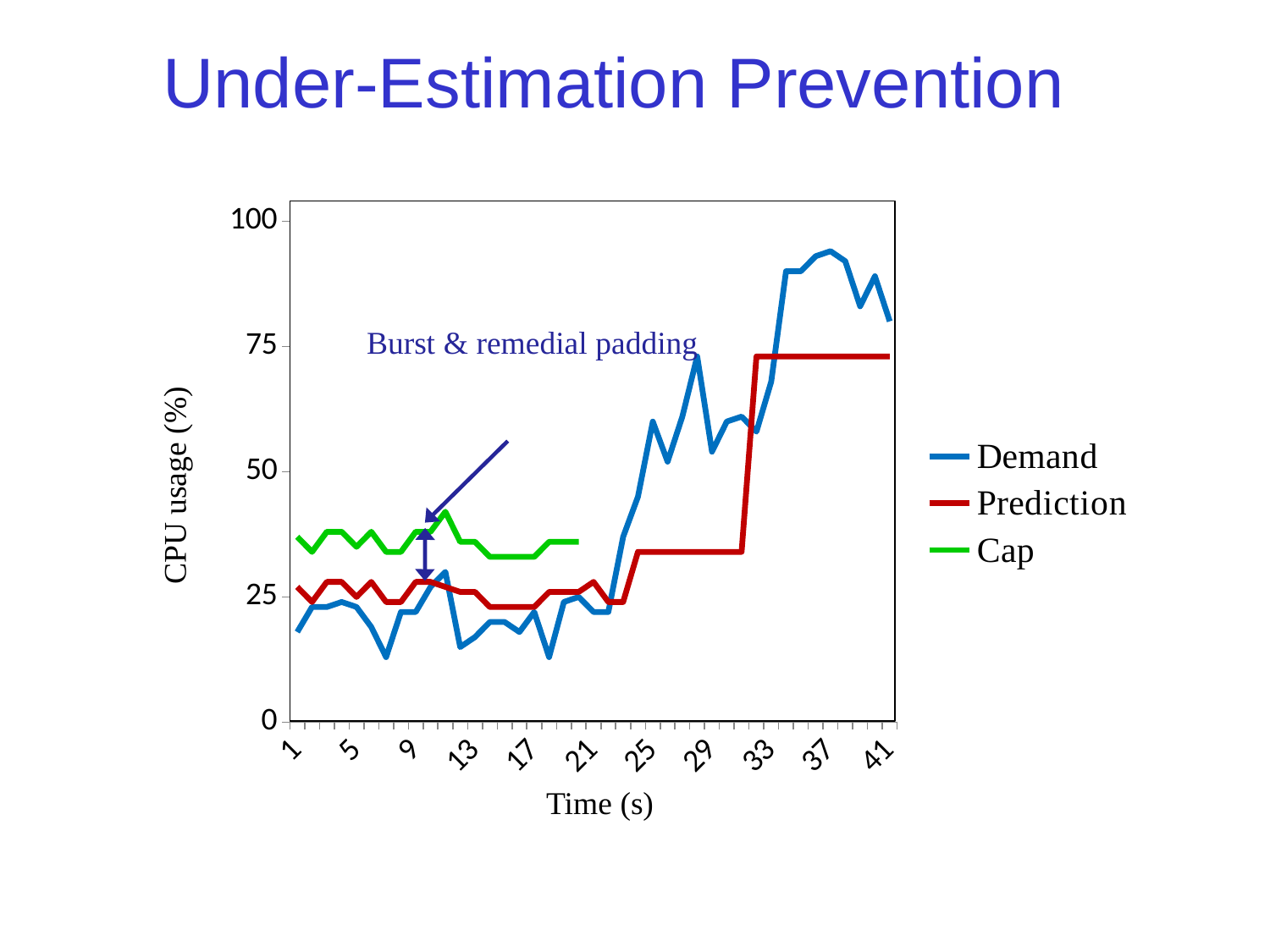
At time 37, which is larger, Demand or Prediction? Demand Is the Demand value at time 29 greater or less than 50? greater Which series reaches the highest value on the chart? Demand Is the Demand value at time 7 greater or less than 25? less What are the three series named in the legend? Demand, Prediction, Cap At time 9, which is larger, Cap or Demand? Cap Is the Prediction value at time 37 greater or less than 50? greater What kind of chart is shown on the slide? line chart How many series does the legend list? 3 What is the label of the y axis? CPU usage (%)